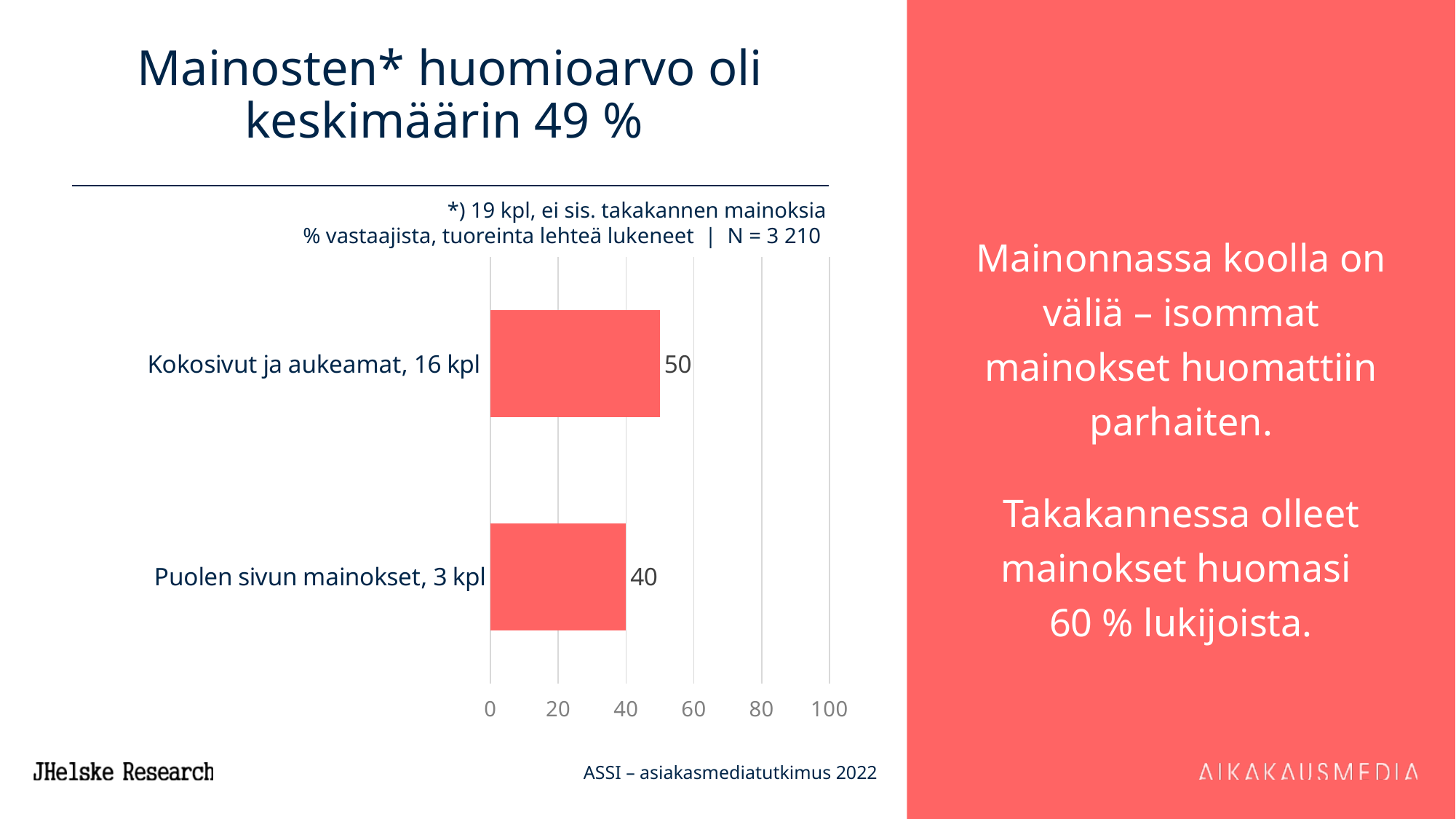
Which is larger: the value for "Kokosivut ja aukeamat, 16 kpl" or for "Puolen sivun mainokset, 3 kpl"? Kokosivut ja aukeamat, 16 kpl What is the maximum value shown on the chart's value axis? 100 What is the value for "Kokosivut ja aukeamat, 16 kpl"? 50 What is the value for "Puolen sivun mainokset, 3 kpl"? 40 What is the difference between the values for "Kokosivut ja aukeamat, 16 kpl" and "Puolen sivun mainokset, 3 kpl"? 10 Is the value for "Kokosivut ja aukeamat, 16 kpl" greater or less than 60? less Which category has the lowest value? Puolen sivun mainokset, 3 kpl Which category has the highest value? Kokosivut ja aukeamat, 16 kpl What kind of chart is shown on the slide? bar chart Is the value for "Puolen sivun mainokset, 3 kpl" greater or less than 20? greater What colour are the bars in the chart? red How many categories are shown in the chart? 2